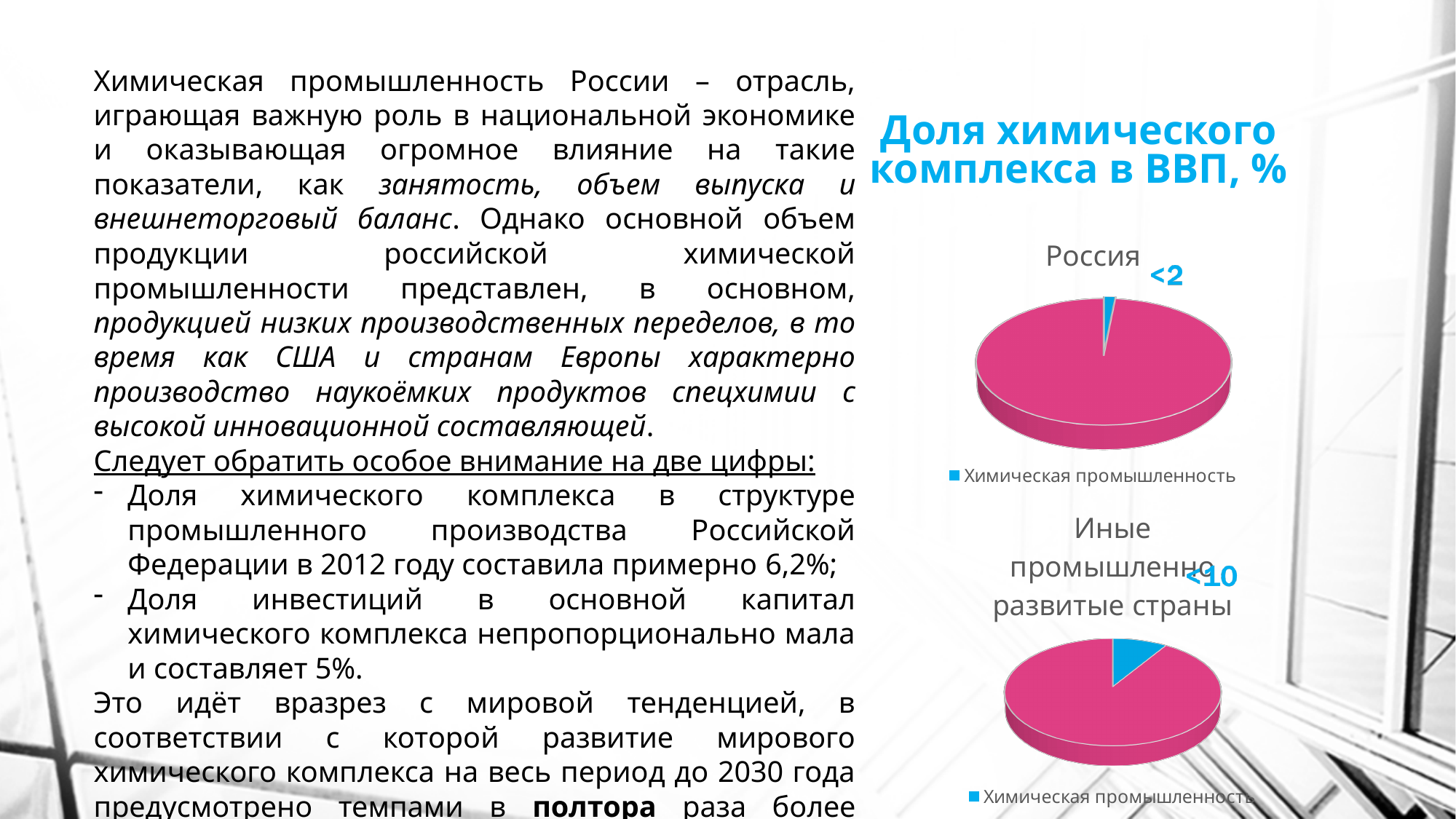
What type of chart is used under the heading "Иные промышленно развитые страны"? pie chart Which pie chart shows the smaller blue slice for the chemical industry, "Россия" or "Иные промышленно развитые страны"? Россия In the "Иные промышленно развитые страны" pie chart, is the blue slice for the chemical industry greater or less than half of the pie? less What type of chart is used under the heading "Россия"? pie chart How many pie charts are shown on the slide? 2 How many entries does the legend of the "Россия" pie chart list? 1 In the "Иные промышленно развитые страны" pie chart, what data label is printed next to the blue slice? <10 What is the overall title printed above the two pie charts? Доля химического комплекса в ВВП, % In the "Россия" pie chart, what data label is printed next to the blue slice? <2 Which pie chart shows the larger blue slice for the chemical industry, "Россия" or "Иные промышленно развитые страны"? Иные промышленно развитые страны What is the legend entry shown below the "Россия" pie chart? Химическая промышленность In the "Россия" pie chart, is the blue slice for the chemical industry greater or less than half of the pie? less